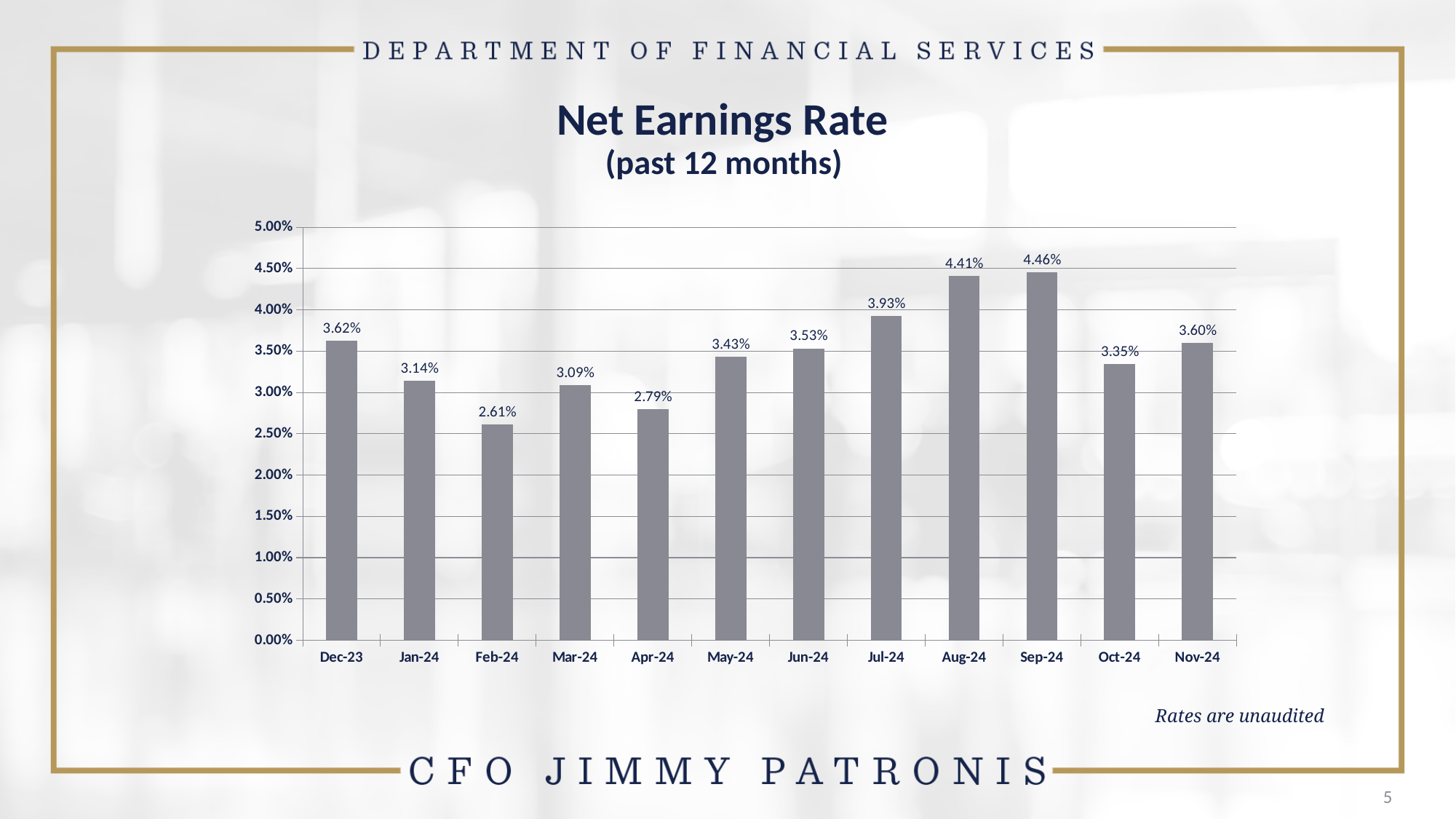
What is the difference between the net earnings rate in Sep-24 and Oct-24? 1.11% What is the net earnings rate for Feb-24? 2.61% Which month has the highest net earnings rate? Sep-24 What is the net earnings rate for Dec-23? 3.62% What kind of chart is shown on the slide? Bar chart What is the net earnings rate for Sep-24? 4.46% Does the net earnings rate rise or fall from Apr-24 to Sep-24? Rise What is the title of the chart? Net Earnings Rate (past 12 months) Is the net earnings rate for Aug-24 greater or less than 4.00%? greater Which month has a higher net earnings rate, Jun-24 or Jul-24? Jul-24 How many months are shown on the chart? 12 Which month has the lowest net earnings rate? Feb-24